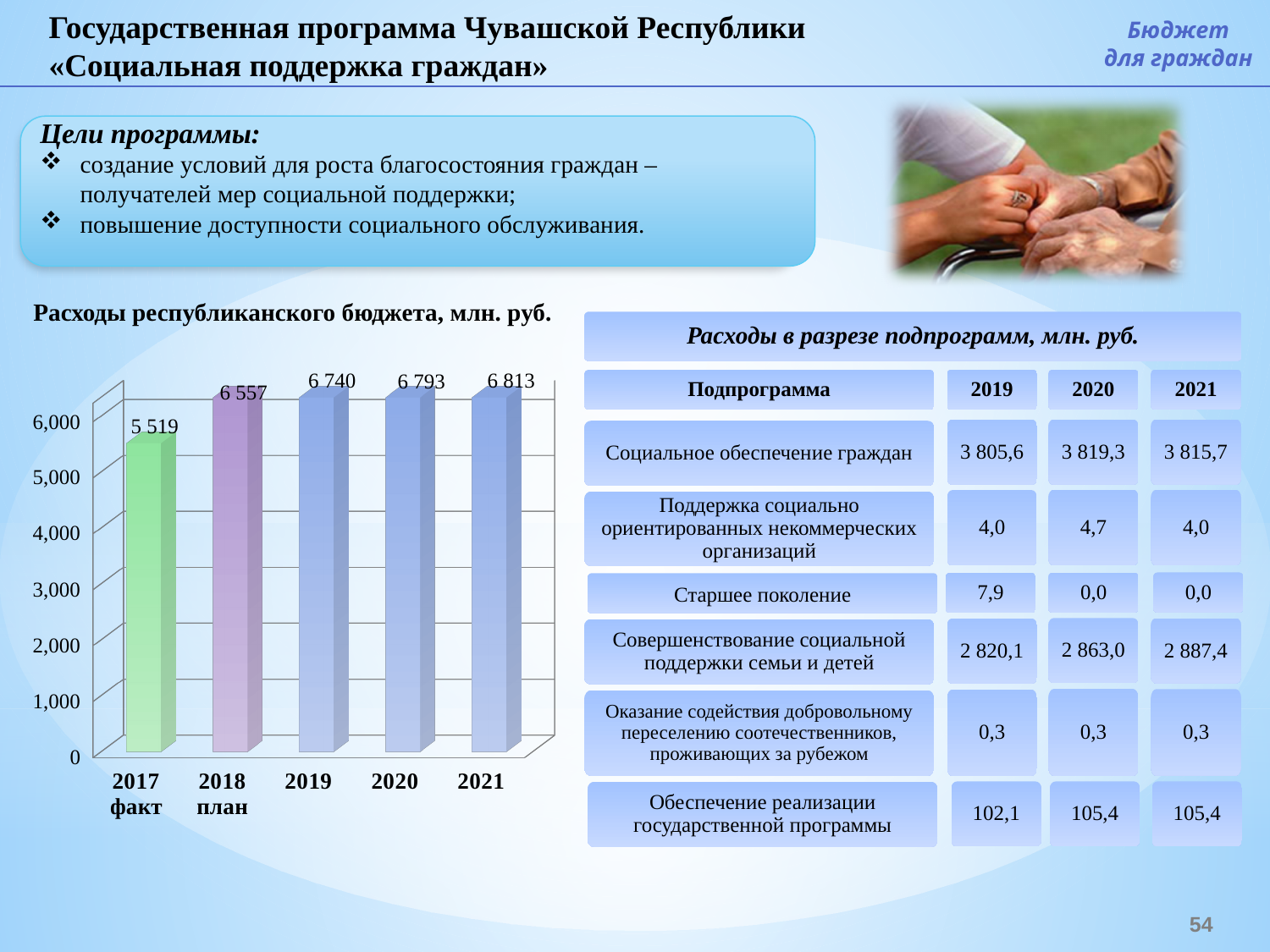
What is the value for 2021 in the chart 'Расходы республиканского бюджета, млн. руб.'? 6 813 What is the difference between the 2018 план and 2017 факт values in the chart 'Расходы республиканского бюджета, млн. руб.'? 1 038 Which year has the lowest value in the chart 'Расходы республиканского бюджета, млн. руб.'? 2017 факт Is the value for 2017 факт in the chart 'Расходы республиканского бюджета, млн. руб.' greater or less than 6,000? less What is the value for 2018 план in the chart 'Расходы республиканского бюджета, млн. руб.'? 6 557 What is the difference between the 2021 and 2019 values in the chart 'Расходы республиканского бюджета, млн. руб.'? 73 What is the value for 2017 факт in the chart 'Расходы республиканского бюджета, млн. руб.'? 5 519 Which year has the highest value in the chart 'Расходы республиканского бюджета, млн. руб.'? 2021 Do the values in the chart 'Расходы республиканского бюджета, млн. руб.' rise or fall from 2017 to 2021? rise How many bars are shown in the chart 'Расходы республиканского бюджета, млн. руб.'? 5 In the chart 'Расходы республиканского бюджета, млн. руб.', which is larger: the value for 2019 or the value for 2018 план? 2019 What type of chart is 'Расходы республиканского бюджета, млн. руб.'? bar chart